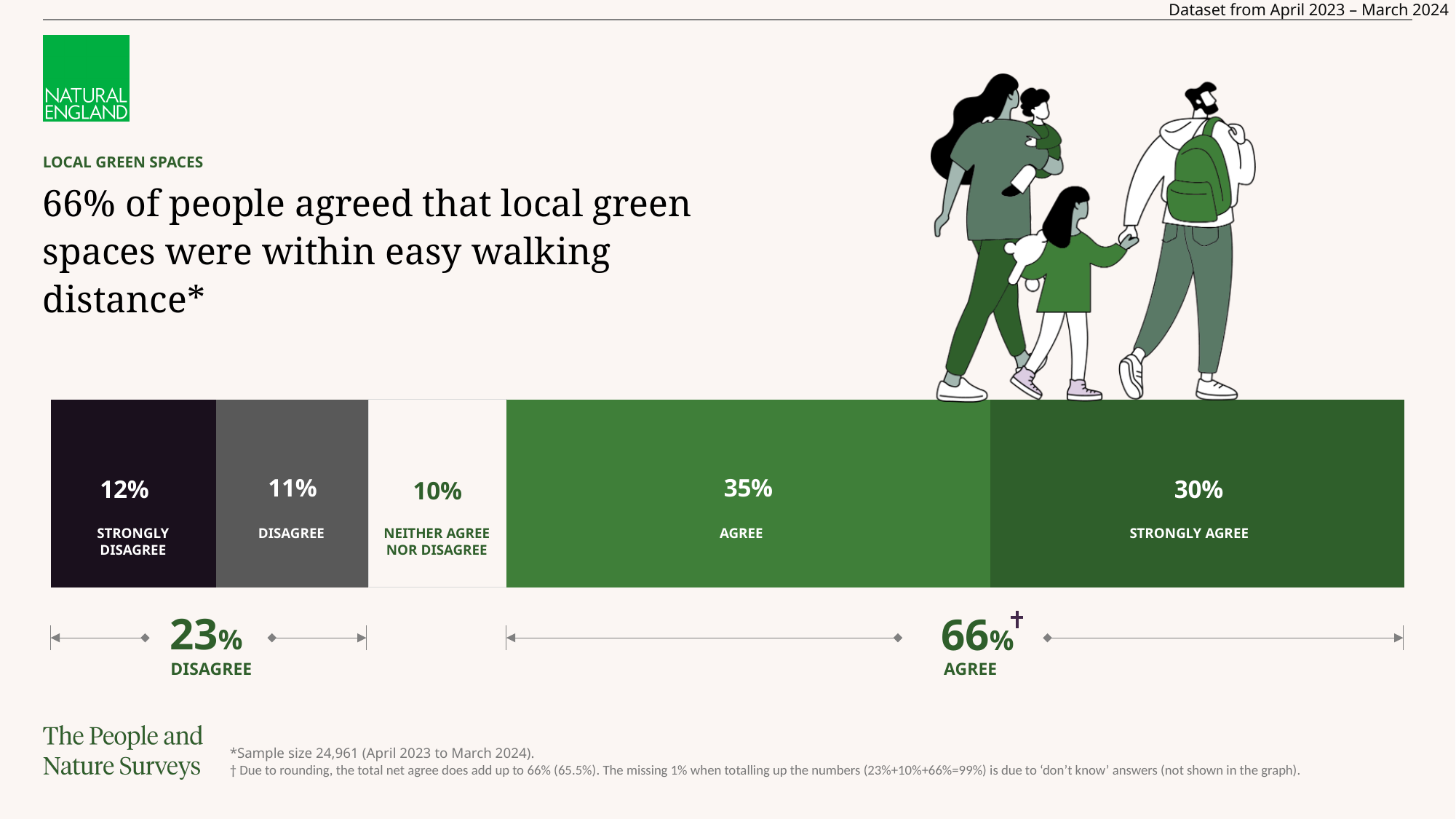
How many response categories are shown in the bar? 5 What kind of chart is used to show the responses? Stacked bar chart Which response category has the lowest percentage? Neither agree nor disagree What percentage of people strongly disagreed? 12% What is the difference between the 'Agree' and 'Strongly agree' percentages? 5% What is the combined percentage shown for 'Agree' (agree plus strongly agree)? 66% What percentage of people selected 'Neither agree nor disagree'? 10% What percentage of people selected 'Agree'? 35% What percentage of people strongly agreed that local green spaces were within easy walking distance? 30% Which response category has the highest percentage? Agree Which is larger, the 'Strongly disagree' percentage or the 'Disagree' percentage? Strongly disagree What is the combined percentage shown for 'Disagree' (strongly disagree plus disagree)? 23%